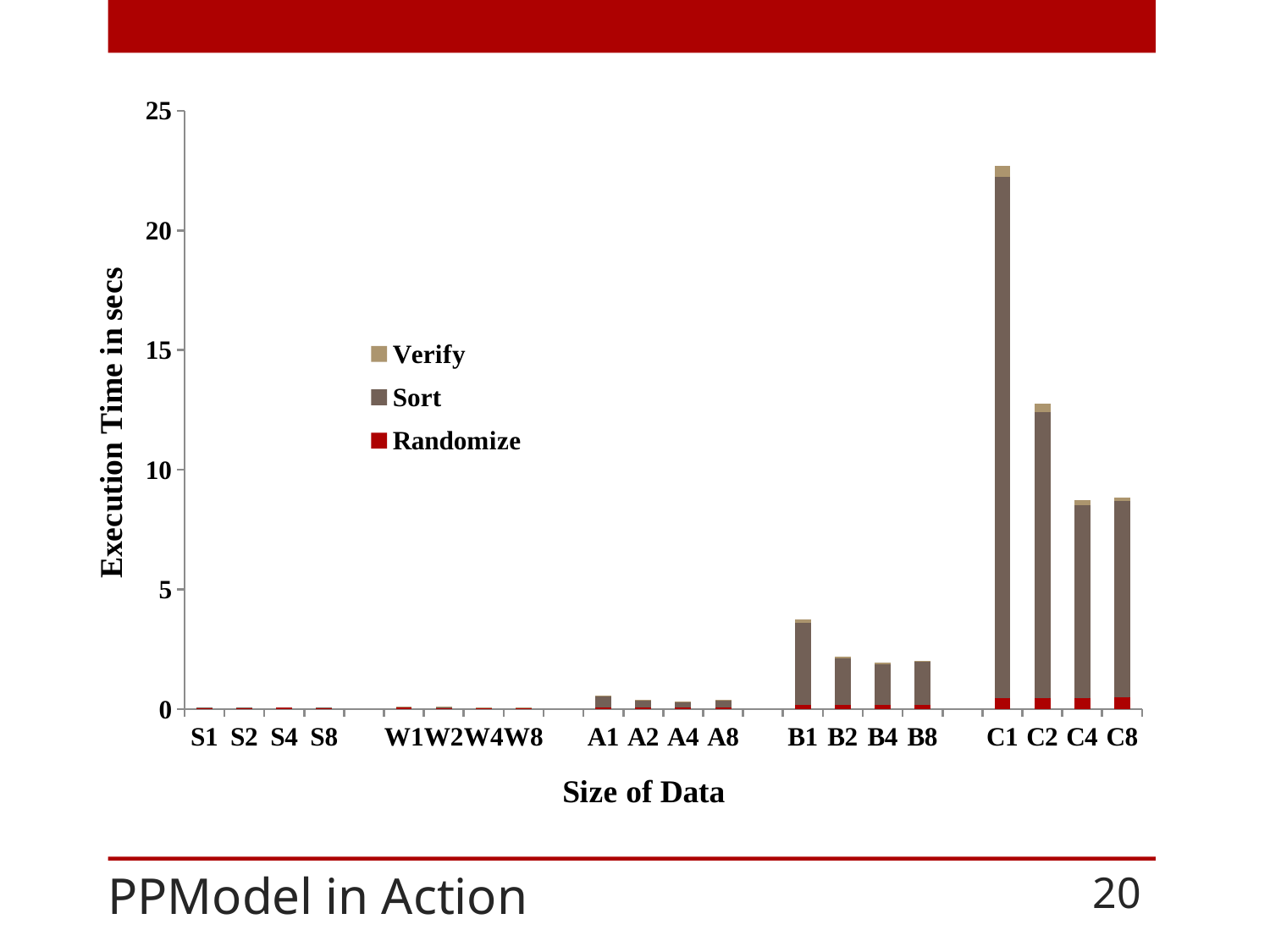
Is the total value for C2 greater or less than 10? greater Is the total value for C1 greater or less than 20? greater How many series does the legend list? 3 Which has the larger total execution time, B1 or B2? B1 Is the total value for B1 greater or less than 5? less Which category has the highest total execution time? C1 What is the title of the x axis? Size of Data What is the title of the y axis? Execution Time in secs What kind of chart is shown on the slide? Stacked bar chart How many categories are shown along the x axis? 20 Which has the larger total execution time, C1 or C2? C1